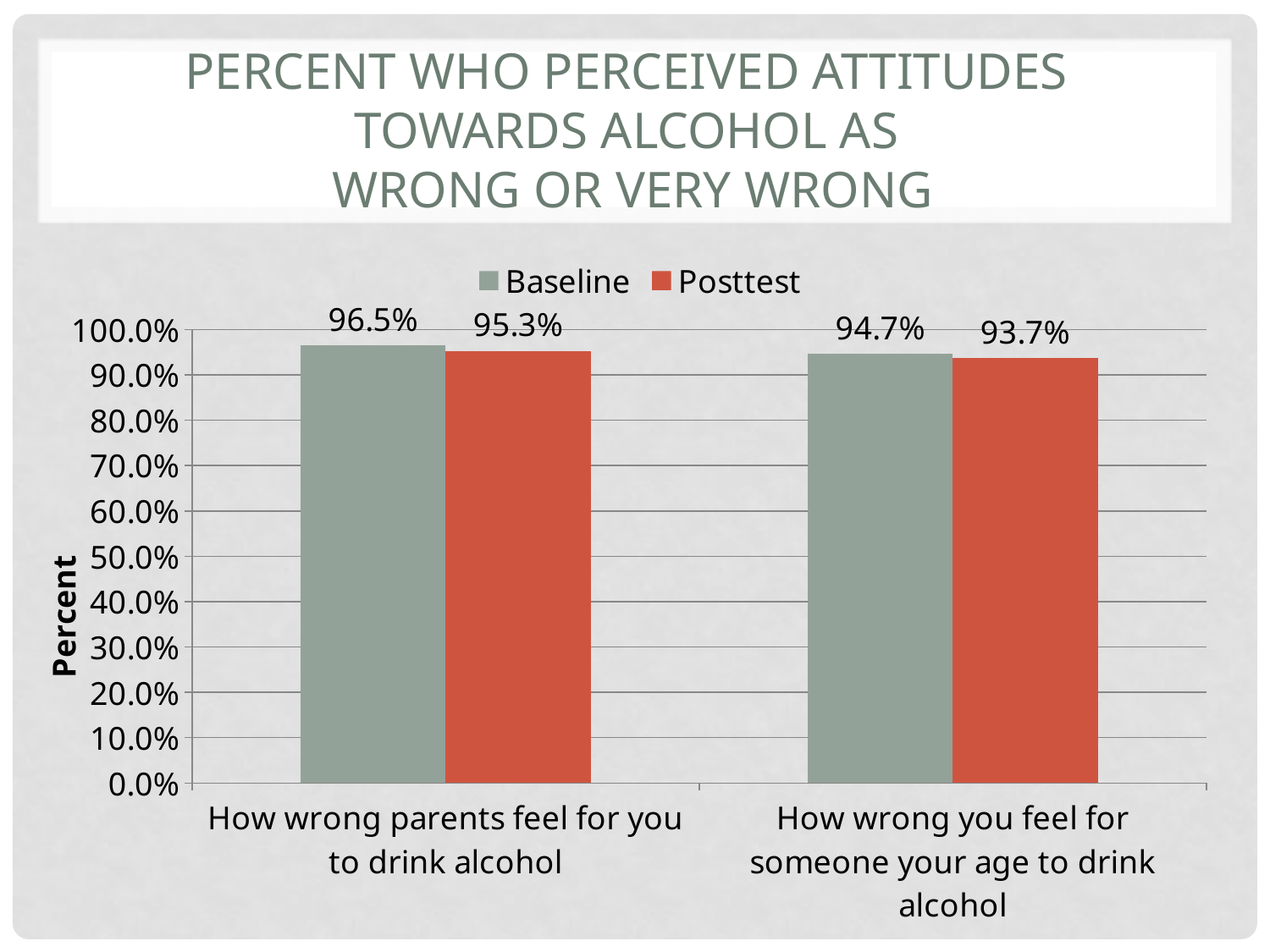
Which series has the higher value for "How wrong parents feel for you to drink alcohol", Baseline or Posttest? Baseline How many series does the legend list? 2 Which category has the lowest Posttest value? How wrong you feel for someone your age to drink alcohol What is the Baseline value for "How wrong parents feel for you to drink alcohol"? 96.5% What is the difference between the Baseline and Posttest values for "How wrong you feel for someone your age to drink alcohol"? 1.0% How many categories are shown on the x axis? 2 What is the difference between the Baseline and Posttest values for "How wrong parents feel for you to drink alcohol"? 1.2% What is the Baseline value for "How wrong you feel for someone your age to drink alcohol"? 94.7% What is the Posttest value for "How wrong parents feel for you to drink alcohol"? 95.3% What is the Posttest value for "How wrong you feel for someone your age to drink alcohol"? 93.7% What is the label on the vertical axis? Percent What kind of chart is shown on the slide? Bar chart